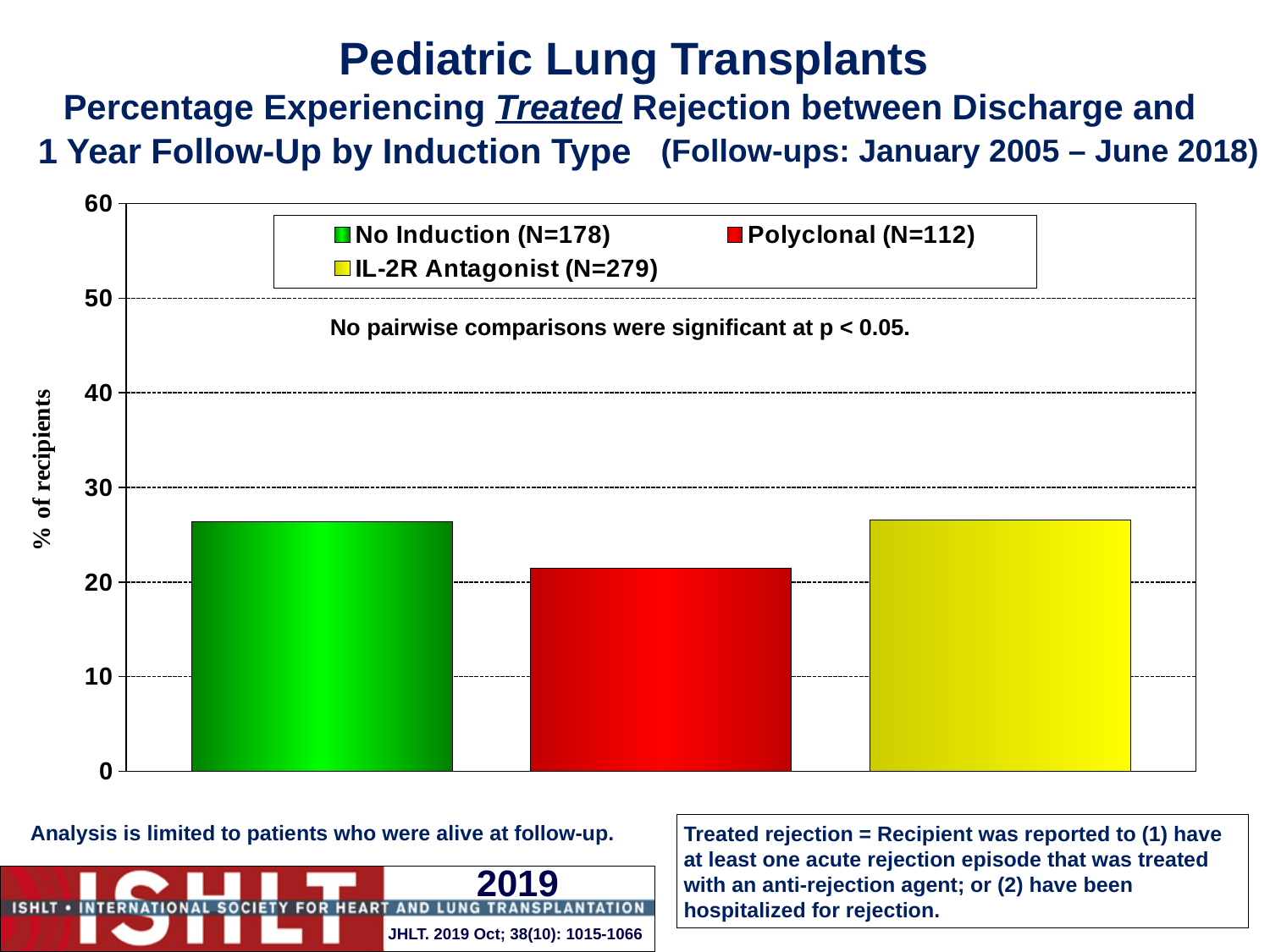
Is the value for IL-2R Antagonist greater or less than 20? greater Which induction type has the lowest percentage of recipients experiencing treated rejection? Polyclonal How many series does the legend list? 3 Is the value for No Induction greater or less than 20? greater What is the N for the IL-2R Antagonist group shown in the legend? 279 Which is larger, the value for IL-2R Antagonist or the value for Polyclonal? IL-2R Antagonist Is the value for Polyclonal greater or less than 30? less What is the label on the y axis of the chart? % of recipients What kind of chart is shown on the slide? Bar chart Which is larger, the value for No Induction or the value for Polyclonal? No Induction How many bars are plotted in the chart? 3